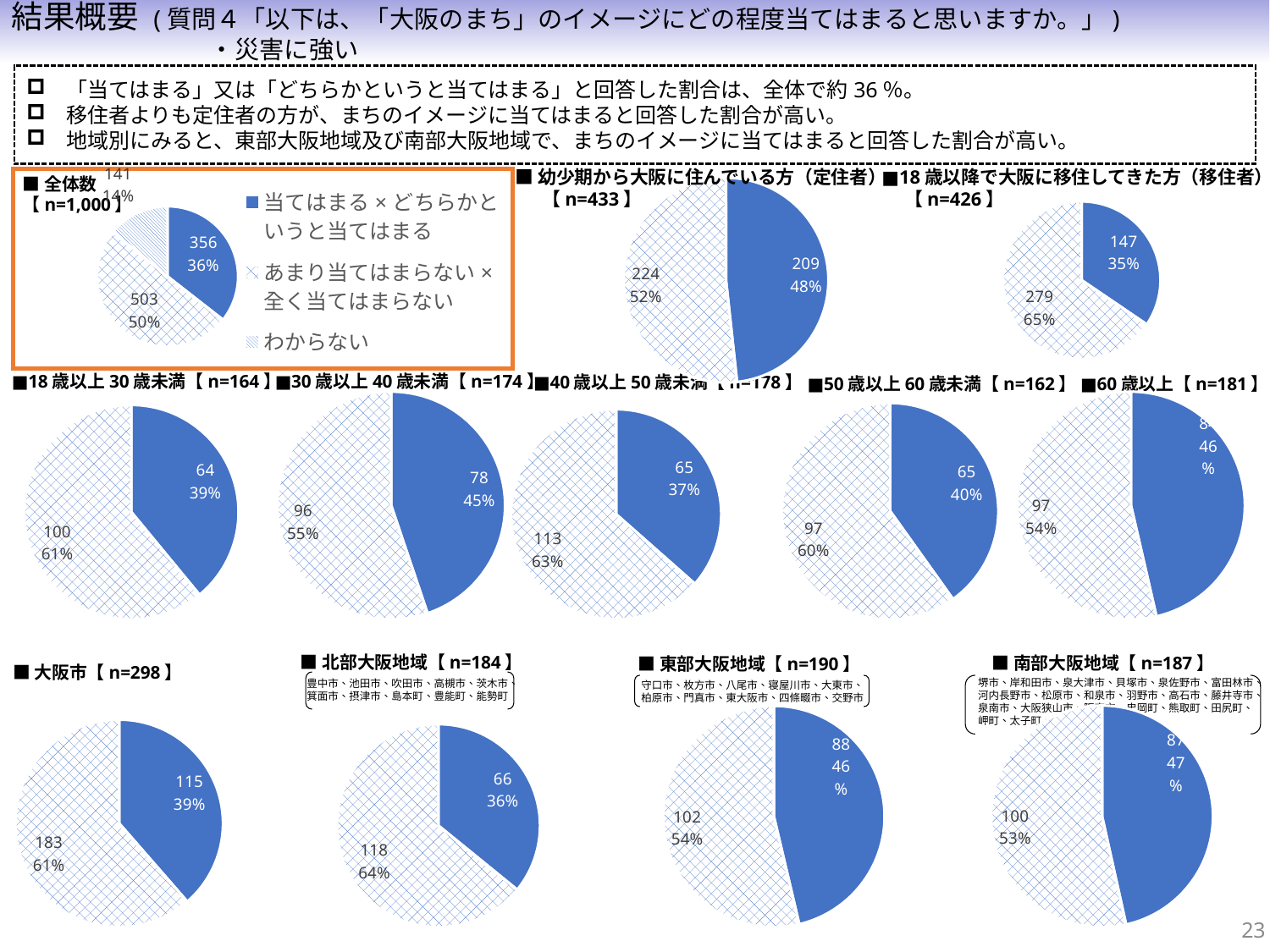
In the 全体数【n=1,000】 pie chart, what percentage is shown for 当てはまる×どちらかというと当てはまる? 36% What is the difference in percentage points between the blue slice in the 30歳以上40歳未満【n=174】 pie chart (45%) and the blue slice in the 40歳以上50歳未満【n=178】 pie chart (37%)? 8 percentage points In the 北部大阪地域【n=184】 pie chart, what percentage is shown for the あまり当てはまらない×全く当てはまらない slice? 64% Among the four regional pie charts (大阪市, 北部大阪地域, 東部大阪地域, 南部大阪地域), which has the highest percentage for the blue (当てはまる) slice? 南部大阪地域【n=187】 In the 大阪市【n=298】 pie chart, how many respondents are in the blue (当てはまる) slice? 115 What kind of chart is used for the 幼少期から大阪に住んでいる方（定住者）【n=433】 data? pie chart In the 18歳以降で大阪に移住してきた方（移住者）【n=426】 pie chart, how many respondents are in the あまり当てはまらない×全く当てはまらない slice? 279 In the 幼少期から大阪に住んでいる方（定住者）【n=433】 pie chart, what percentage is shown for the blue (当てはまる) slice? 48% In the 全体数【n=1,000】 pie chart, how many respondents answered あまり当てはまらない×全く当てはまらない? 503 How many entries does the legend next to the 全体数 pie chart list? 3 Which is larger: the blue slice percentage in the 定住者【n=433】 pie chart or in the 移住者【n=426】 pie chart? 定住者【n=433】 In the 全体数【n=1,000】 pie chart, what share of the pie is わからない? 14%